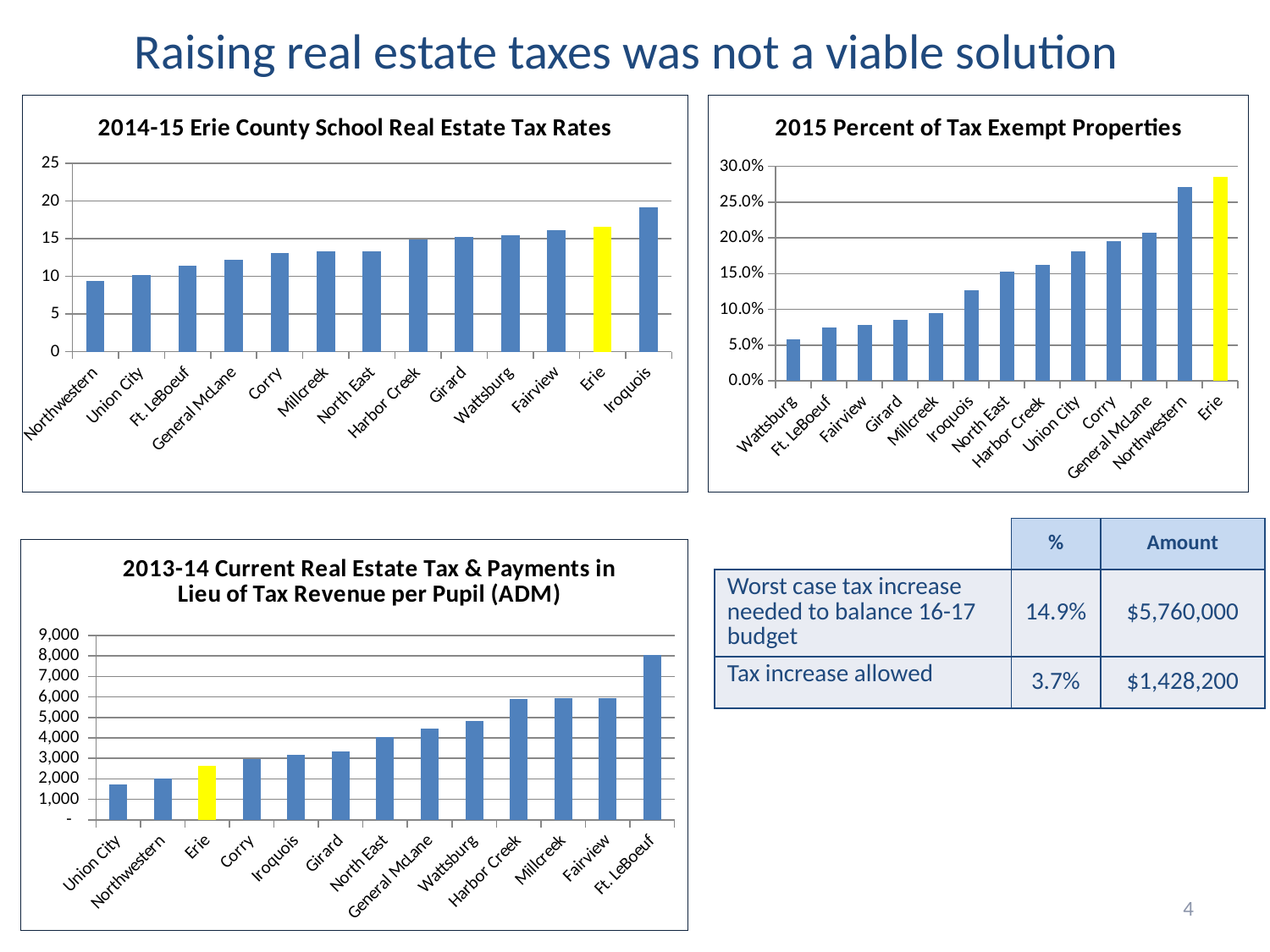
In the chart titled '2014-15 Erie County School Real Estate Tax Rates', is the value for Erie greater or less than 15? greater In the chart titled '2014-15 Erie County School Real Estate Tax Rates', which district has the lowest tax rate? Northwestern In the chart titled '2014-15 Erie County School Real Estate Tax Rates', how many districts are shown? 13 In the chart titled '2015 Percent of Tax Exempt Properties', is the value for Northwestern greater or less than 25.0%? greater In the chart titled '2015 Percent of Tax Exempt Properties', which district has the highest percentage? Erie In the chart titled '2015 Percent of Tax Exempt Properties', which district has the lowest percentage? Wattsburg In the chart titled '2014-15 Erie County School Real Estate Tax Rates', which district has the highest tax rate? Iroquois In the chart titled '2013-14 Current Real Estate Tax & Payments in Lieu of Tax Revenue per Pupil (ADM)', do the values rise or fall from left to right along the x axis? rise In the chart titled '2015 Percent of Tax Exempt Properties', which is larger, the value for Corry or the value for Girard? Corry What kind of chart is the one titled '2015 Percent of Tax Exempt Properties'? bar chart In the chart titled '2013-14 Current Real Estate Tax & Payments in Lieu of Tax Revenue per Pupil (ADM)', is the value for Erie greater or less than 2,000? greater In the chart titled '2013-14 Current Real Estate Tax & Payments in Lieu of Tax Revenue per Pupil (ADM)', which district has the highest value? Ft. LeBoeuf